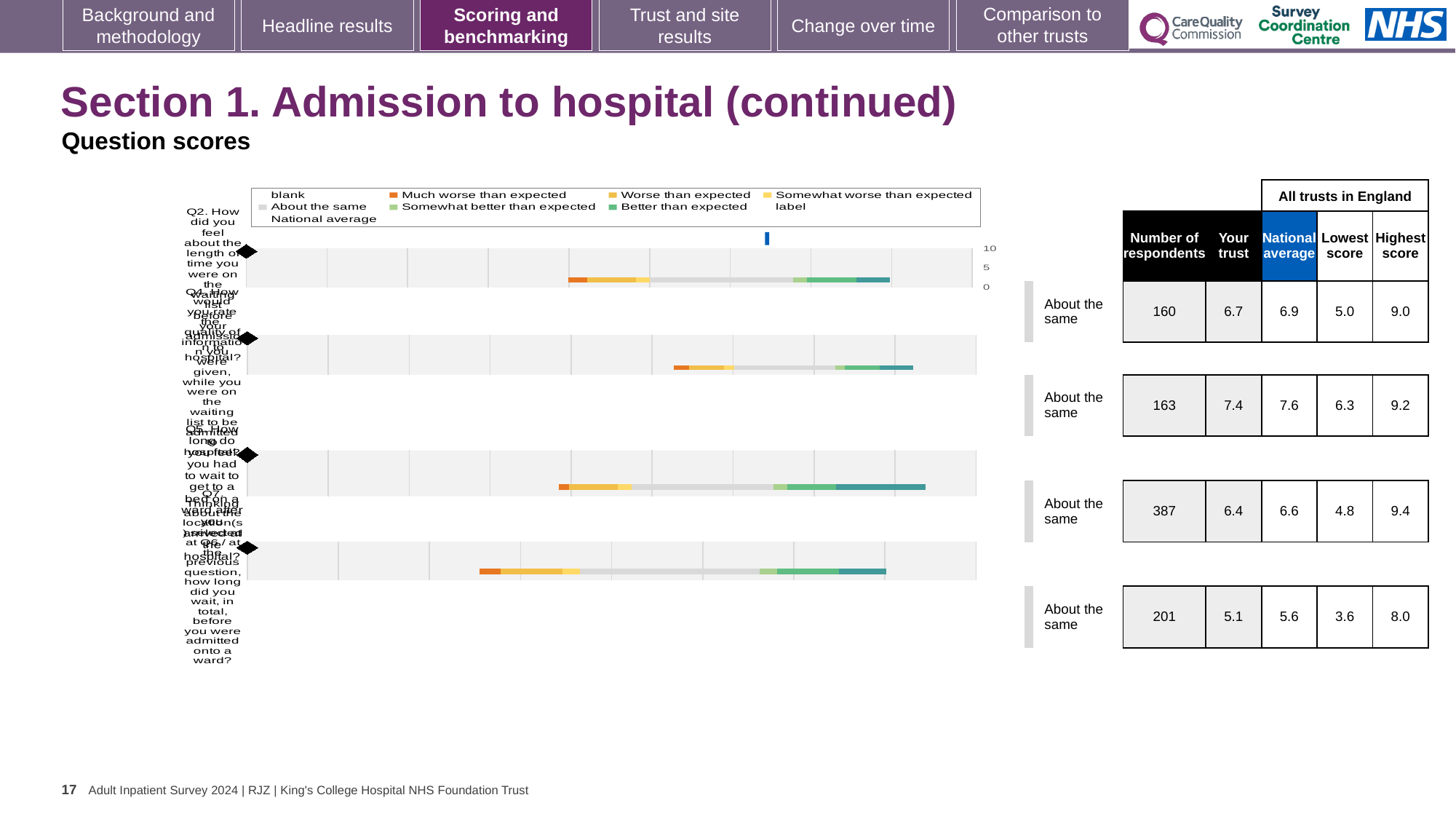
How many question rows (bars) are plotted in the chart? 4 In the table, what is the national average for the third row (Q5)? 6.6 In the table, what is the 'Your trust' score for the second row (Q4)? 7.4 What kind of chart is shown on the slide? bar chart What is the highest score shown in the 'Highest score' column of the table? 9.4 In the table, what is the lowest score for the fourth row (Q7)? 3.6 In the table, what is the number of respondents for the first row (Q2)? 160 Is the 'Your trust' score in the second row (Q4) larger or smaller than the national average in that row? smaller Which row of the table has the highest number of respondents? the third row (Q5), 387 Which row of the table has the lowest 'Your trust' score? the fourth row (Q7), 5.1 What benchmark label is shown next to every question row in the chart? About the same What is the difference between the national average and the 'Your trust' score in the first row (Q2)? 0.2